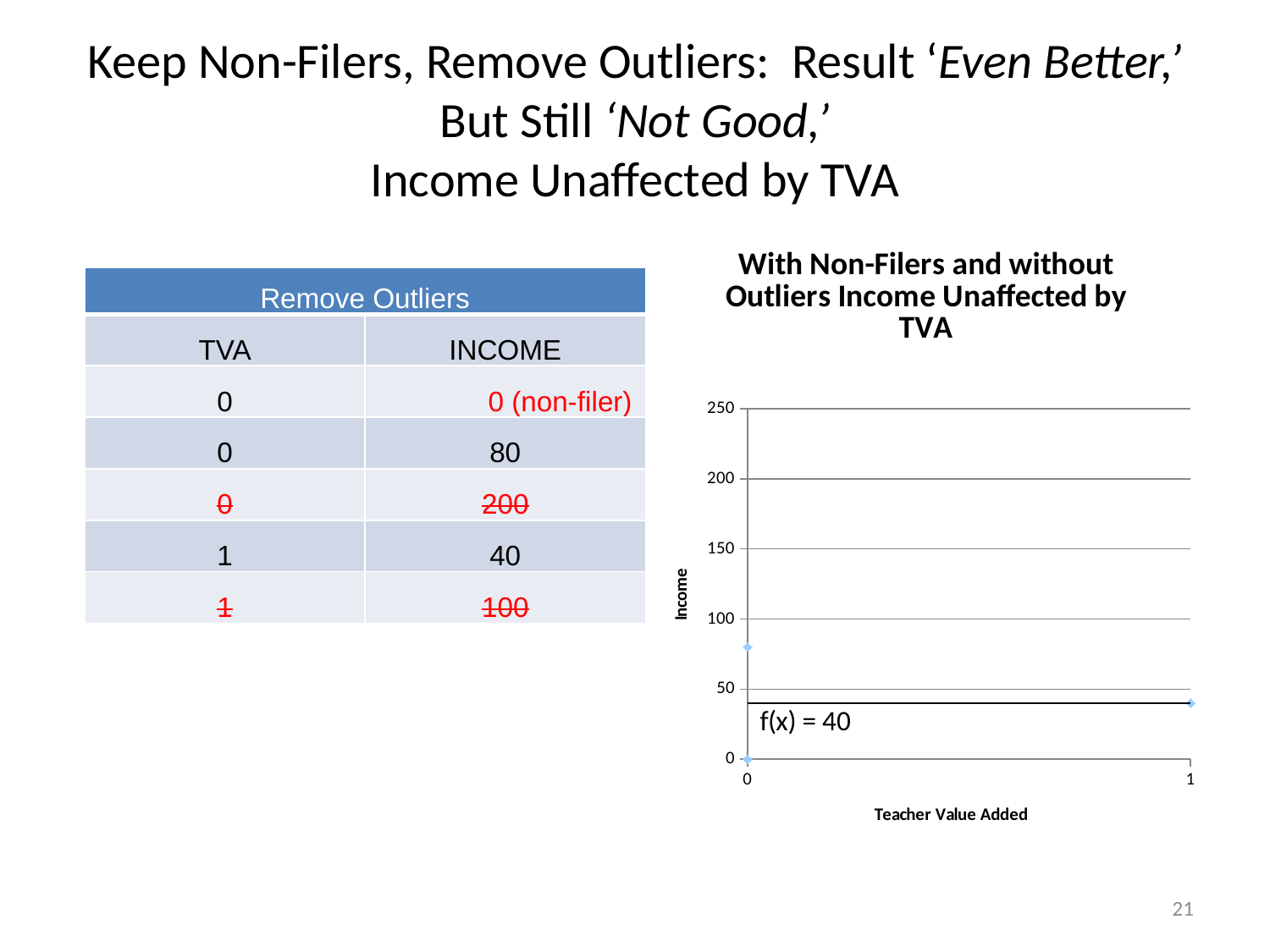
What is the title of the chart? With Non-Filers and without Outliers Income Unaffected by TVA What is the label on the horizontal axis of the chart? Teacher Value Added How many data points are plotted on the chart? 3 Is the Income value of the point at Teacher Value Added 1 greater or less than 50? less Does the trendline rise, fall, or stay flat as Teacher Value Added increases from 0 to 1? Stays flat What is the Income value of the lowest point at Teacher Value Added 0? 0 What is the highest value shown on the Income axis? 250 Is the Income value of the highest point at Teacher Value Added 0 greater or less than 50? greater How many tick labels are shown on the Teacher Value Added axis? 2 What equation is printed for the trendline on the chart? f(x) = 40 What kind of chart is shown on the slide? Scatter chart Is the Income value of the highest point at Teacher Value Added 0 greater or less than 100? less